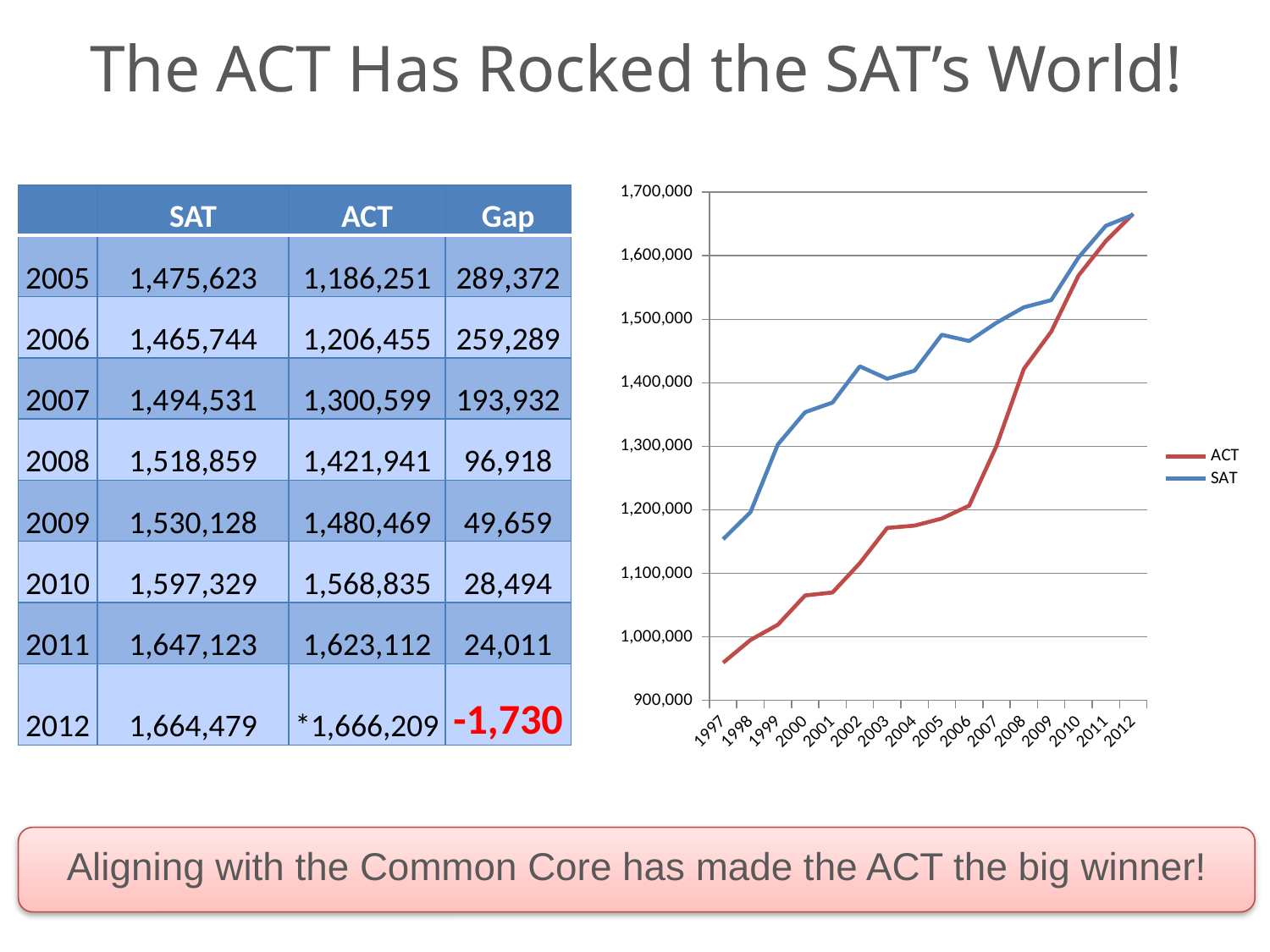
In 2005, which series has the larger value, SAT or ACT? SAT How many years are plotted along the x axis of the chart? 16 Which year is the first one shown on the chart's x axis? 1997 Does the ACT line rise or fall from 1997 to 2012? rise In which year does the ACT line reach its lowest value? 1997 Is the SAT value for 1997 greater or less than 1,100,000? greater What kind of chart is shown on the slide? line chart Which two series are listed in the chart's legend? ACT and SAT How many series does the chart's legend list? 2 Is the ACT value for 1997 greater or less than 1,000,000? less Is the SAT value for 2002 greater or less than 1,400,000? greater